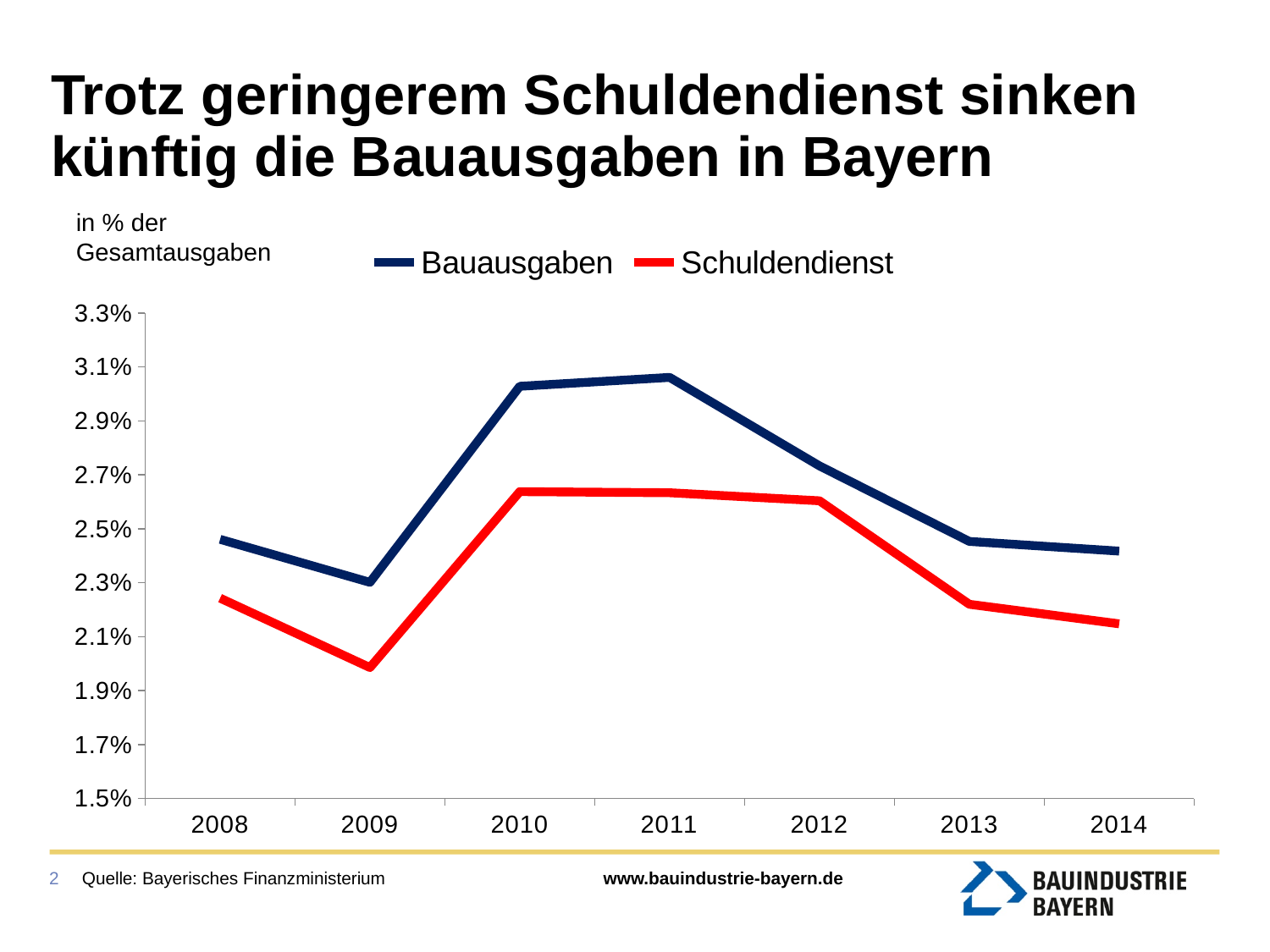
Is the Schuldendienst value for 2014 greater or less than 2.3%? less In which year is the Schuldendienst value lowest? 2009 What kind of chart is shown on the slide? line chart Is the Bauausgaben value for 2011 greater or less than 2.9%? greater Which colour is used for the Schuldendienst line? red Do the Bauausgaben values rise or fall from 2011 to 2014? fall In which year is the Bauausgaben value lowest? 2009 Is the Schuldendienst value for 2009 greater or less than 2.1%? less How many years are shown on the x axis? 7 How many series does the legend list? 2 Which series has the higher value in 2010, Bauausgaben or Schuldendienst? Bauausgaben